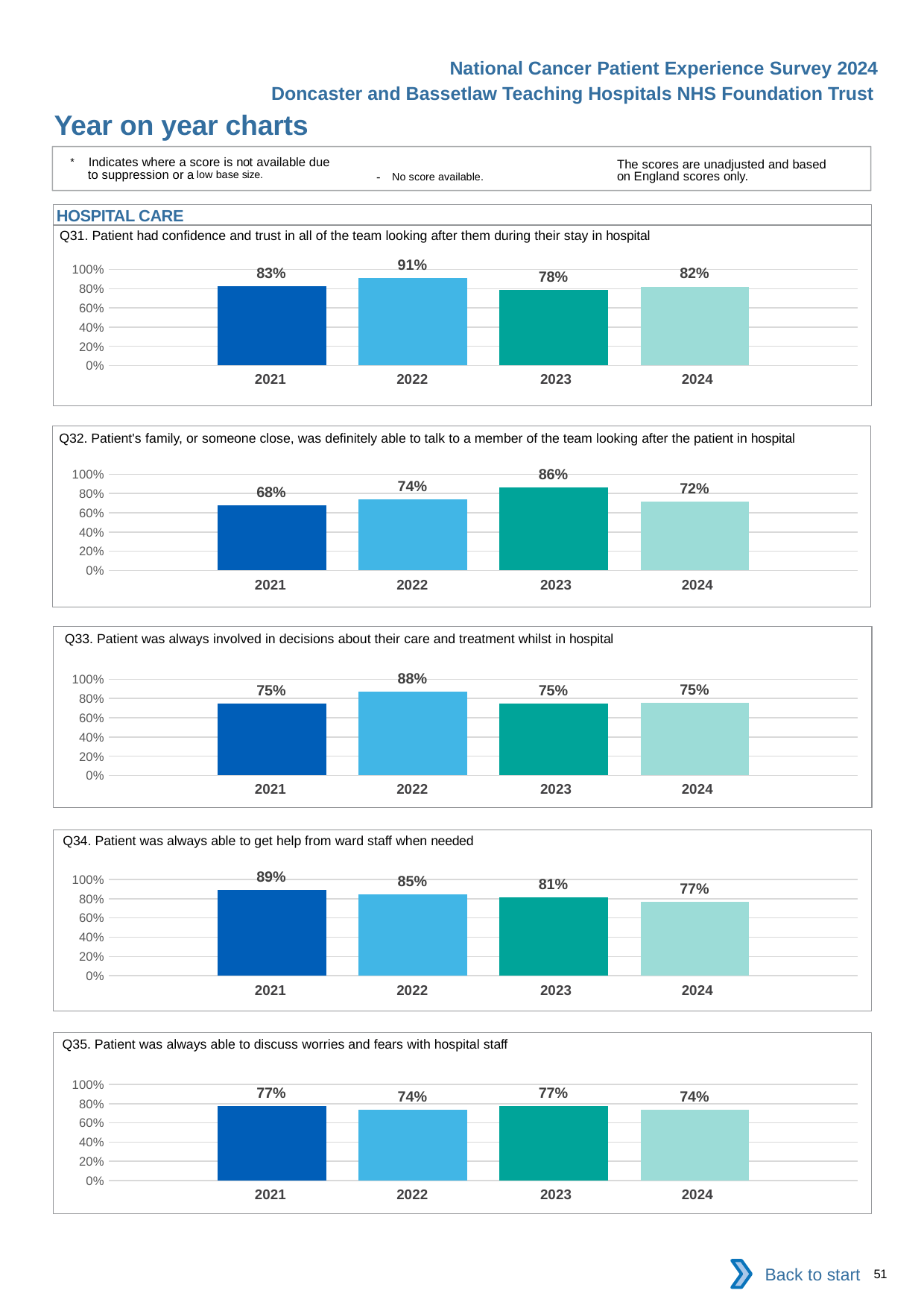
What kind of chart is used for Q31? bar chart In the Q35 chart, which is larger, the value for 2021 or the value for 2022? 2021 In the Q35 chart, what is the difference between the 2021 and 2024 values? 3% In the Q33 chart, how many years are shown on the x axis? 4 In the Q34 chart, do the values rise or fall from 2021 to 2024? fall In the Q31 chart, what is the value for 2022? 91% In the Q32 chart, which year has the highest value? 2023 In the Q32 chart, what is the difference between the 2023 and 2021 values? 18% In the Q33 chart, what is the value for 2022? 88% How many charts are shown on the slide? 5 In the Q31 chart, which year has the lowest value? 2023 In the Q34 chart, what is the value for 2024? 77%